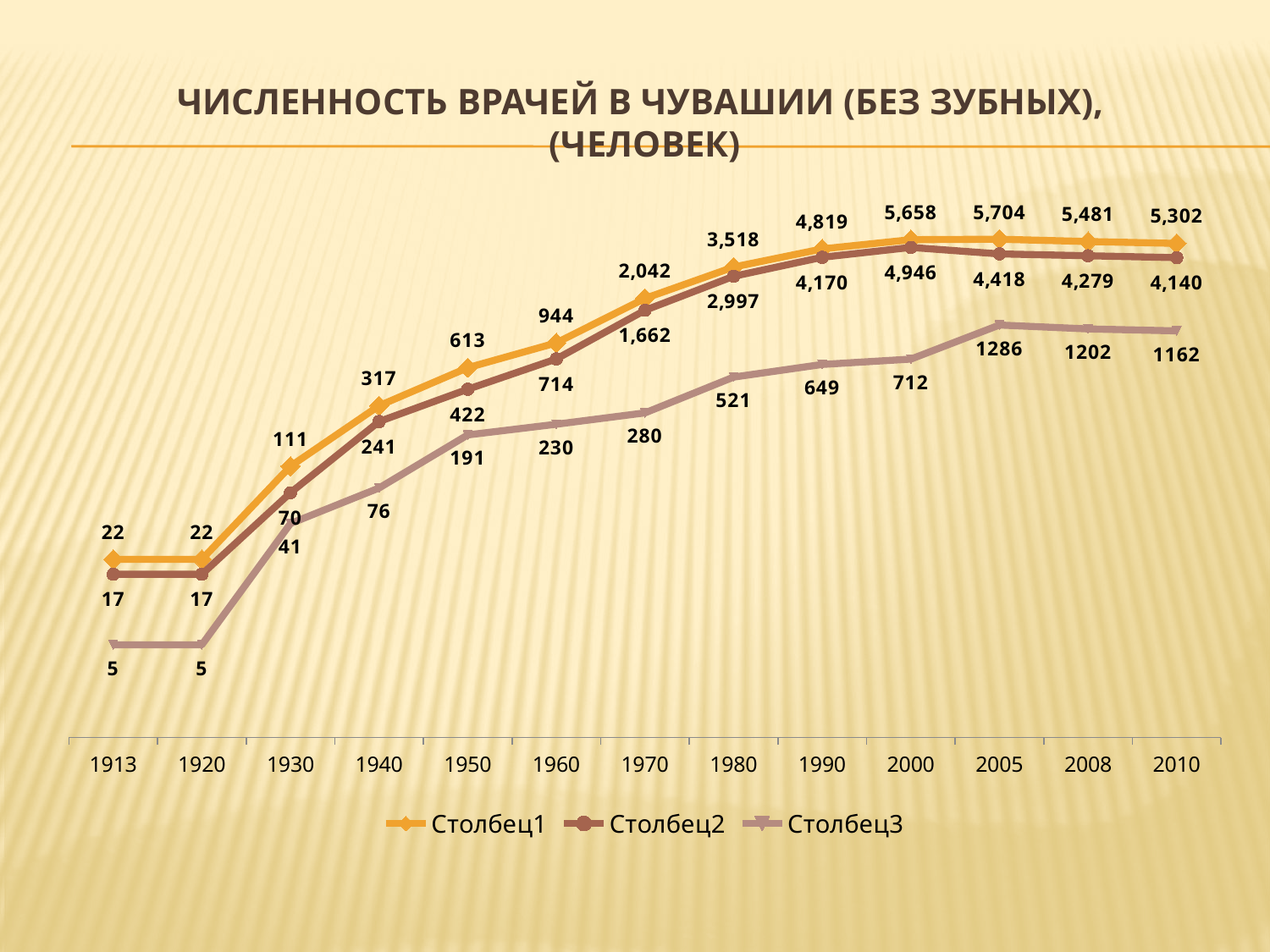
What is the title of the chart? Численность врачей в Чувашии (без зубных), (человек) What kind of chart is shown on the slide? line chart What is the value of Столбец1 in 2005? 5,704 In which year does Столбец2 reach its highest value? 2000 Does Столбец3 rise or fall between 1913 and 2005? rise What is the value of Столбец3 in 2008? 1202 How many series does the legend list? 3 Which is larger in 1990: Столбец1 or Столбец3? Столбец1 What is the value of Столбец2 in 1970? 1,662 How many years are shown on the x axis? 13 What is the difference between Столбец1 and Столбец2 in 2010? 1,162 In which year does Столбец1 reach its highest value? 2005